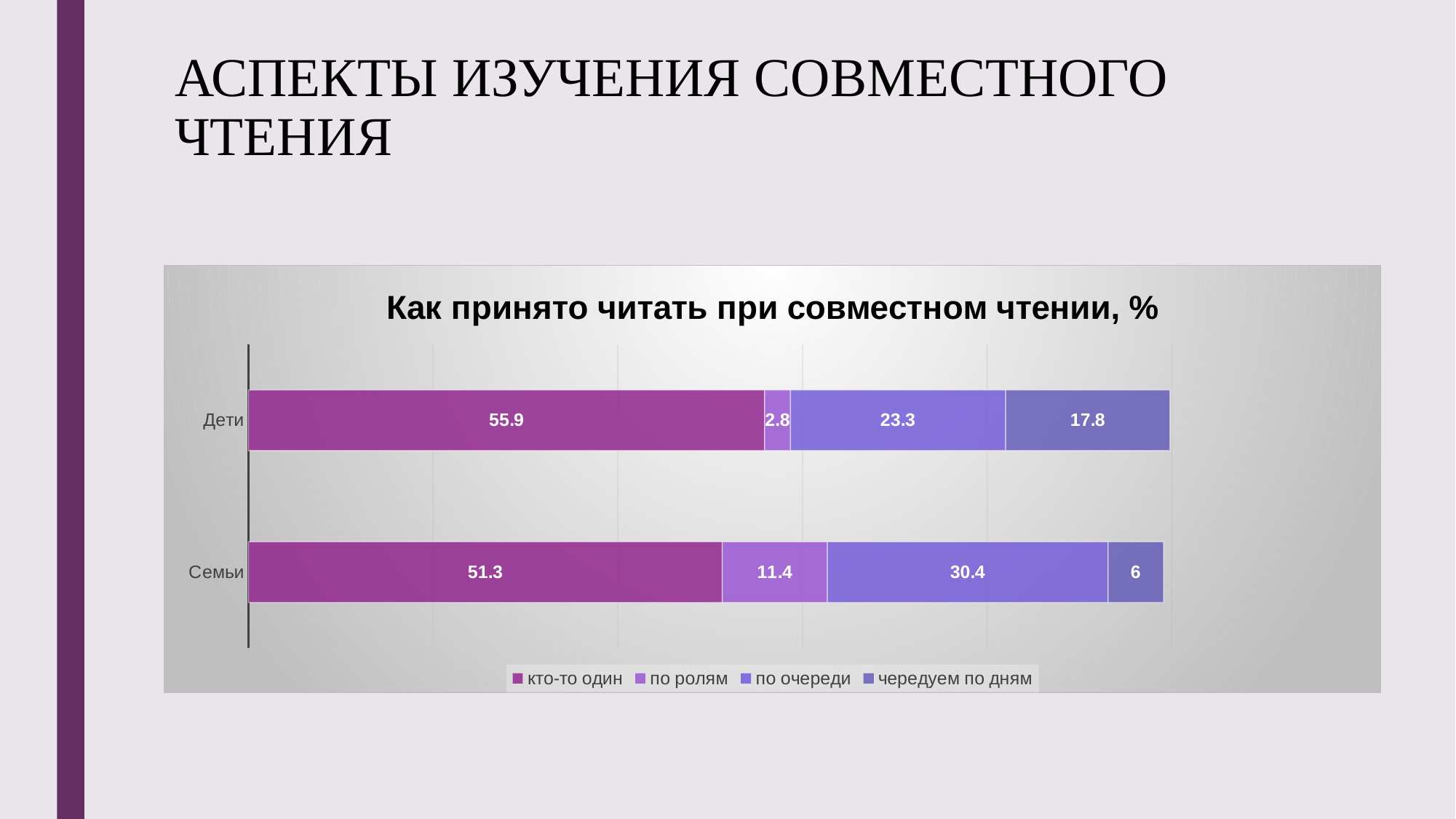
What is the value of 'по очереди' for Дети? 23.3 What is the value of 'чередуем по дням' for Семьи? 6 What is the difference between the 'по очереди' values for Семьи and Дети? 7.1 What is the title of the chart? Как принято читать при совместном чтении, % Which series has the lowest value for Дети? по ролям Which is larger: 'чередуем по дням' for Дети or for Семьи? Дети Which series has the highest value for Семьи? кто-то один How many series does the legend list? 4 How many categories are shown on the chart? 2 What is the value of 'кто-то один' for Дети? 55.9 What is the value of 'по ролям' for Семьи? 11.4 What type of chart is shown on the slide? stacked bar chart